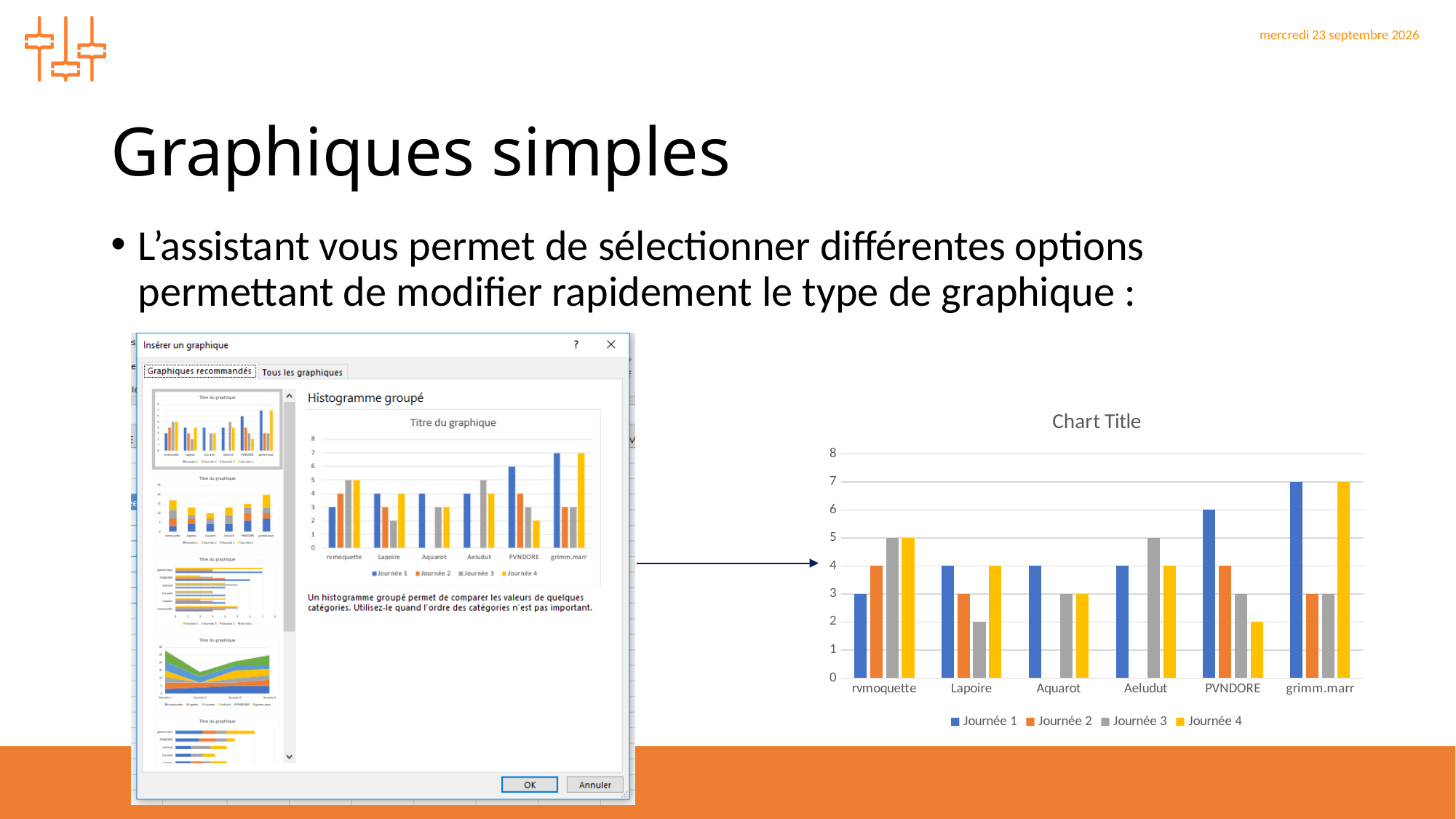
On the chart titled "Chart Title" on the right, what is the value of Journée 1 for grimm.marr? 7 On the chart titled "Chart Title" on the right, what is the difference between the Journée 1 values for grimm.marr and rvmoquette? 4 On the chart titled "Chart Title" on the right, what is the value of Journée 4 for PVNDORE? 2 On the chart titled "Chart Title" on the right, how many series does the legend list? 4 On the chart titled "Chart Title" on the right, which category has the highest Journée 1 value? grimm.marr On the chart titled "Chart Title" on the right, what are the legend entries? Journée 1, Journée 2, Journée 3, Journée 4 On the chart titled "Chart Title" on the right, which is larger: Journée 3 for rvmoquette or Journée 3 for Lapoire? Journée 3 for rvmoquette On the chart titled "Chart Title" on the right, how many categories are shown on the x axis? 6 On the chart titled "Chart Title" on the right, what kind of chart is shown? bar chart On the chart titled "Chart Title" on the right, which category has the lowest Journée 4 value? PVNDORE On the chart titled "Chart Title" on the right, what is the value of Journée 1 for PVNDORE? 6 On the chart titled "Chart Title" on the right, what is the value of Journée 3 for Lapoire? 2